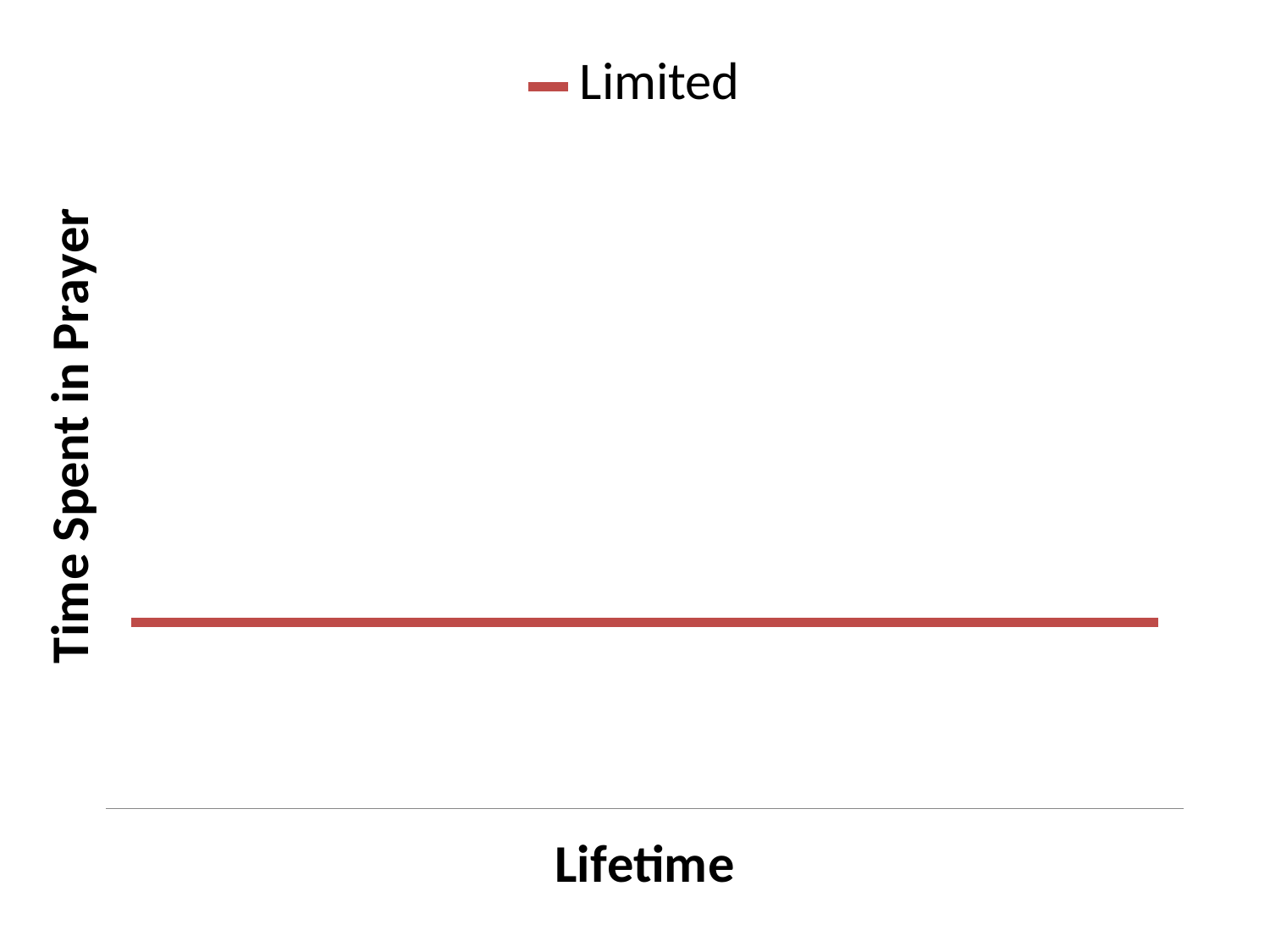
What kind of chart is shown on the slide? line chart Does the Limited line rise, fall, or stay flat across the x axis? stays flat What is the label of the x axis? Lifetime How many series does the legend list? 1 What is the name of the series shown in the legend? Limited What colour is the Limited line? red